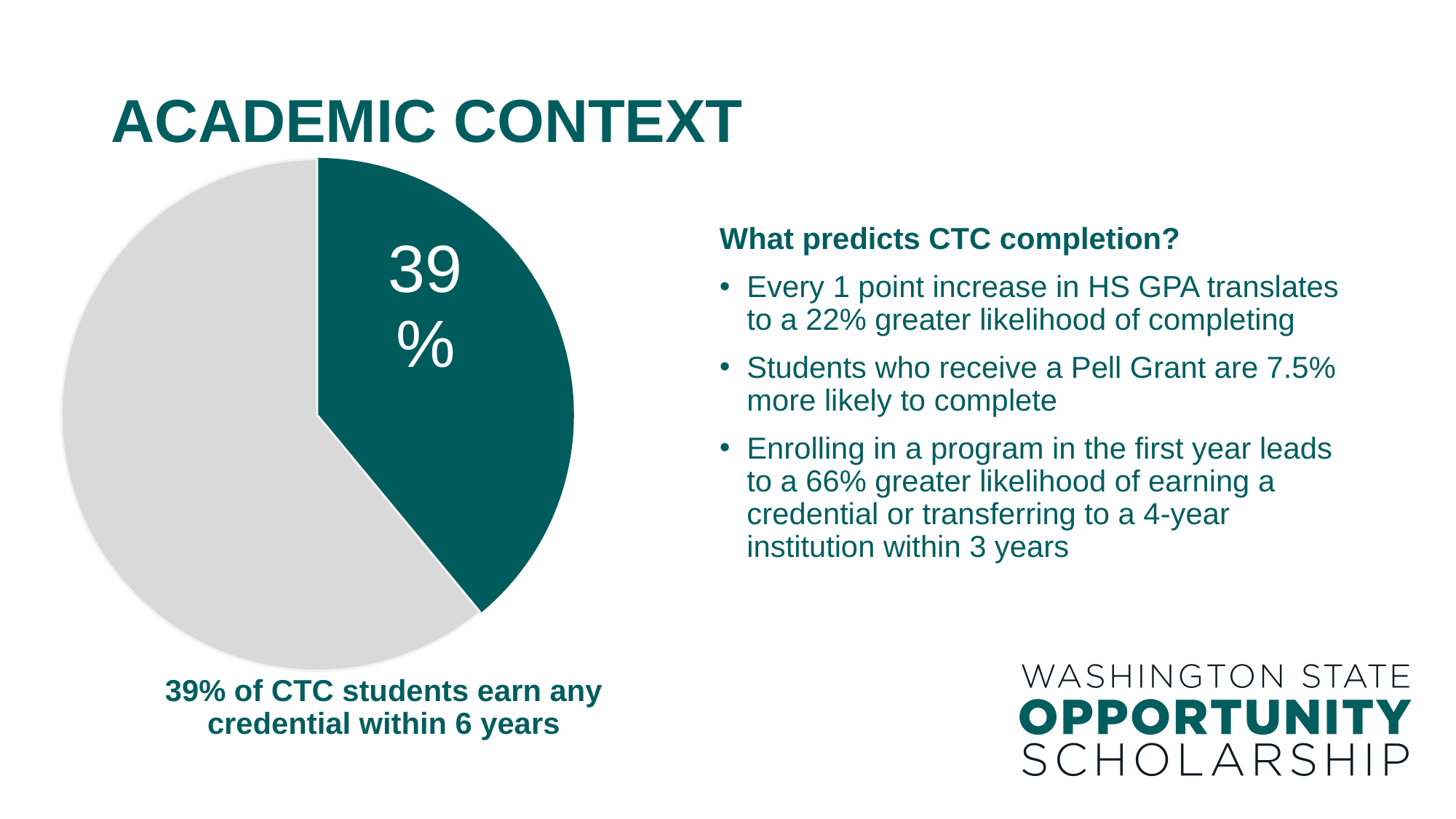
What colour is the slice labelled 39%? teal Which slice of the pie is larger, the teal slice or the grey slice? the grey slice What share of the pie does the teal slice represent? 39% Is the teal slice's share of the pie greater or less than 50%? less What does the caption below the pie chart say? 39% of CTC students earn any credential within 6 years How many slices does the pie chart have? 2 What kind of chart is shown on the slide? pie chart What percentage of CTC students earn any credential within 6 years, according to the pie chart? 39%